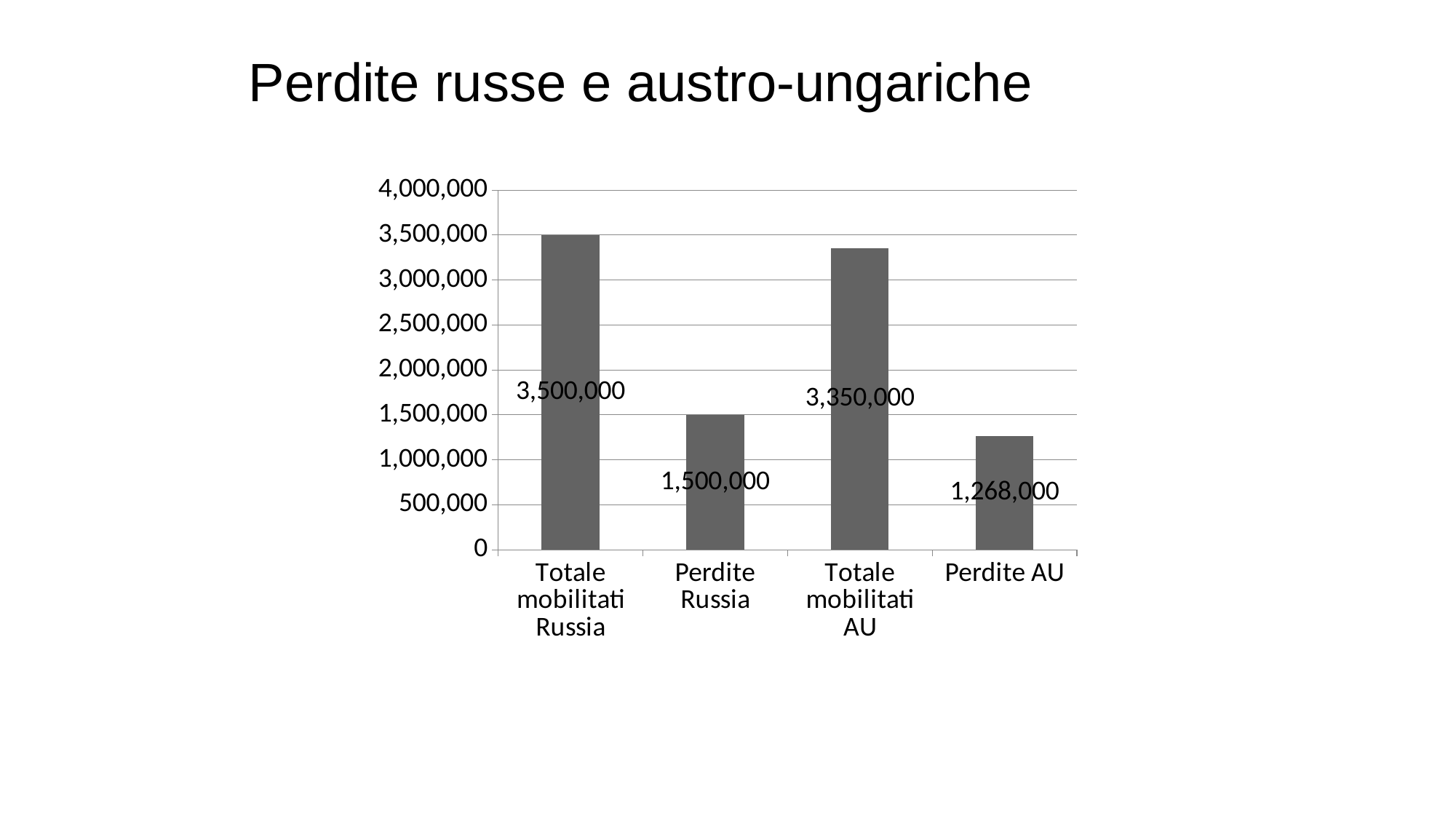
Which is larger, Perdite Russia or Perdite AU? Perdite Russia What is the difference between Totale mobilitati Russia and Totale mobilitati AU? 150,000 What is the value for Totale mobilitati Russia? 3,500,000 What is the value for Perdite AU? 1,268,000 What is the difference between Perdite Russia and Perdite AU? 232,000 Which category has the highest value? Totale mobilitati Russia Which category has the lowest value? Perdite AU What kind of chart is shown on the slide? Bar chart How many categories are shown in the chart? 4 What is the title of the slide? Perdite russe e austro-ungariche What is the value for Perdite Russia? 1,500,000 What is the value for Totale mobilitati AU? 3,350,000